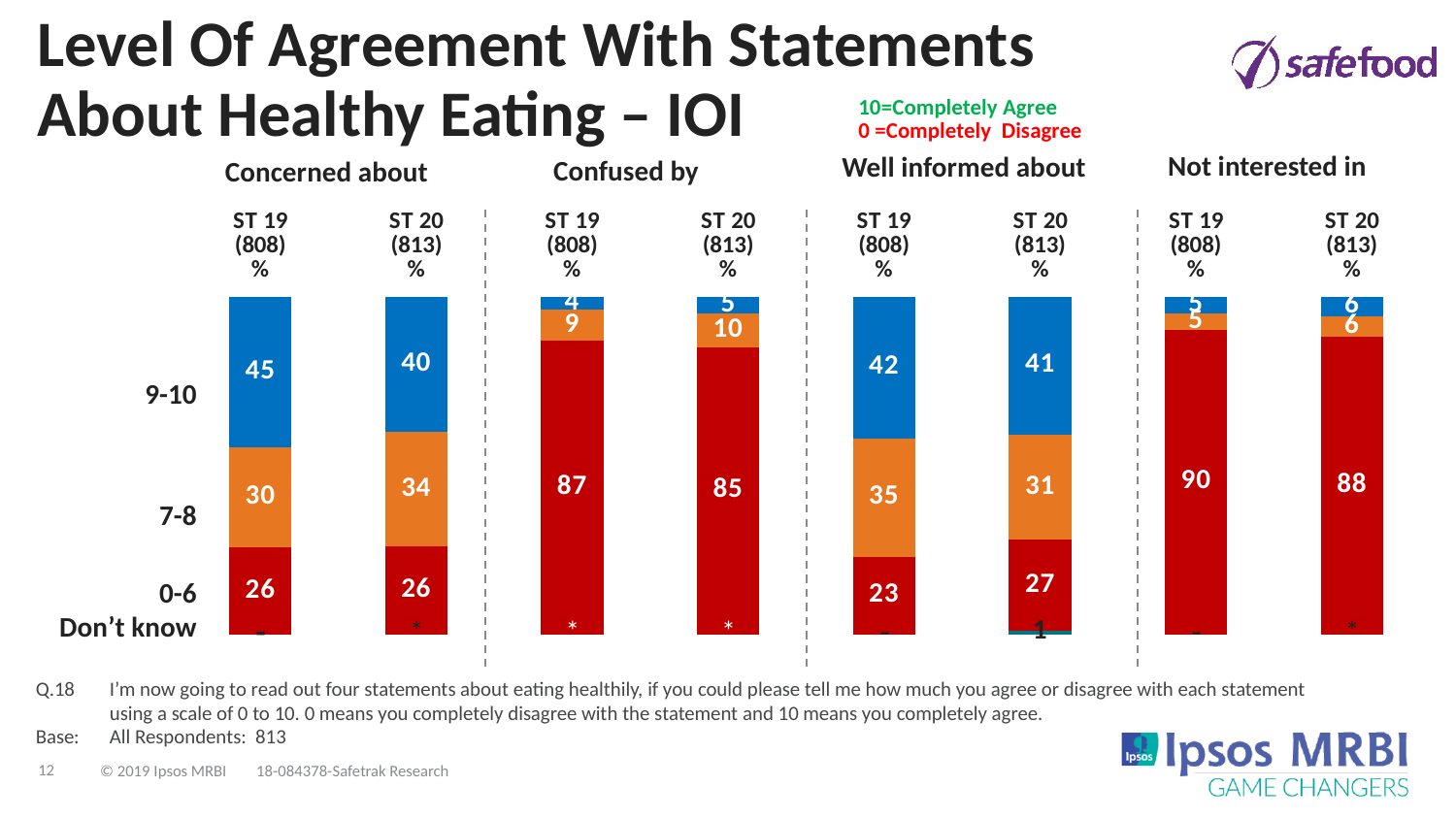
In the 'Well informed about' chart, which is larger: the 0-6 value for ST 19 or for ST 20? ST 20 In the 'Well informed about' chart, what is the 7-8 value for ST 20? 31 In the 'Concerned about' chart, does the 9-10 value rise or fall from ST 19 to ST 20? Fall What type of chart is used on this slide? Stacked bar chart In the 'Concerned about' chart, what is the difference between the 9-10 values for ST 19 and ST 20? 5 In the 'Concerned about' chart, what is the 9-10 value for ST 19? 45 How many bars are shown in the 'Concerned about' chart? 2 In the 'Not interested in' chart, what is the difference between the 0-6 values for ST 19 and ST 20? 2 In the 'Well informed about' chart, what is the Don't know value for ST 20? 1 In the 'Confused by' chart, what is the 0-6 value for ST 20? 85 In the 'Not interested in' chart, what is the 0-6 value for ST 19? 90 In the 'Confused by' chart, which segment is the largest for ST 19? 0-6